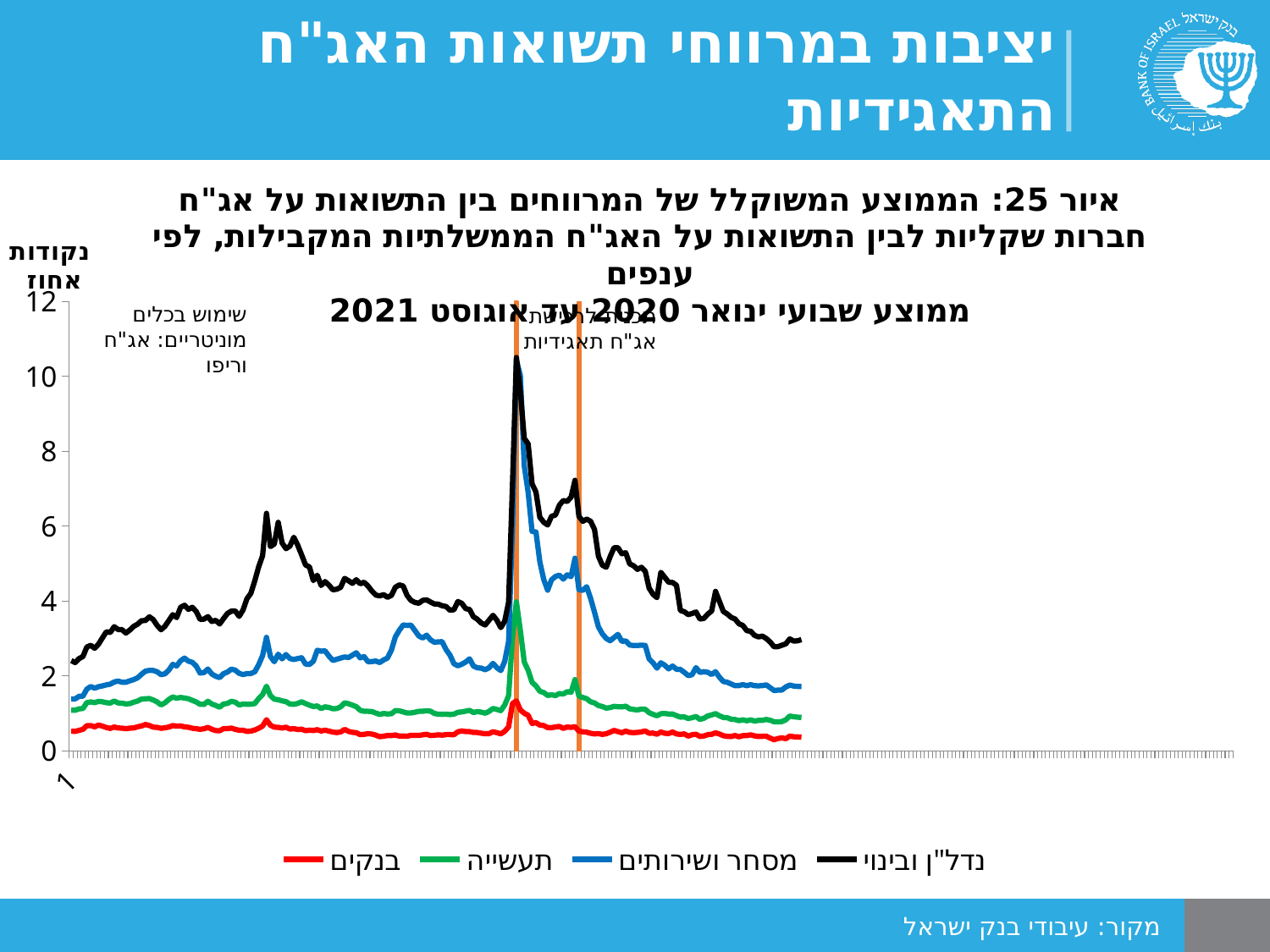
After its main peak, does the נדל"ן ובינוי series rise or fall toward the end of the period? fall Which series is drawn in red according to the legend? בנקים What kind of chart is shown on the slide? line chart Which series reaches the highest value on the chart? נדל"ן ובינוי Is the peak value of the תעשייה series greater or less than 2? greater Which series is drawn in black according to the legend? נדל"ן ובינוי At the main peak, which series is higher: נדל"ן ובינוי or תעשייה? נדל"ן ובינוי Which series stays lowest throughout the chart? בנקים Is the peak value of the בנקים series greater or less than 2? less Is the peak value of the מסחר ושירותים series greater or less than 4? greater How many series does the legend list? 4